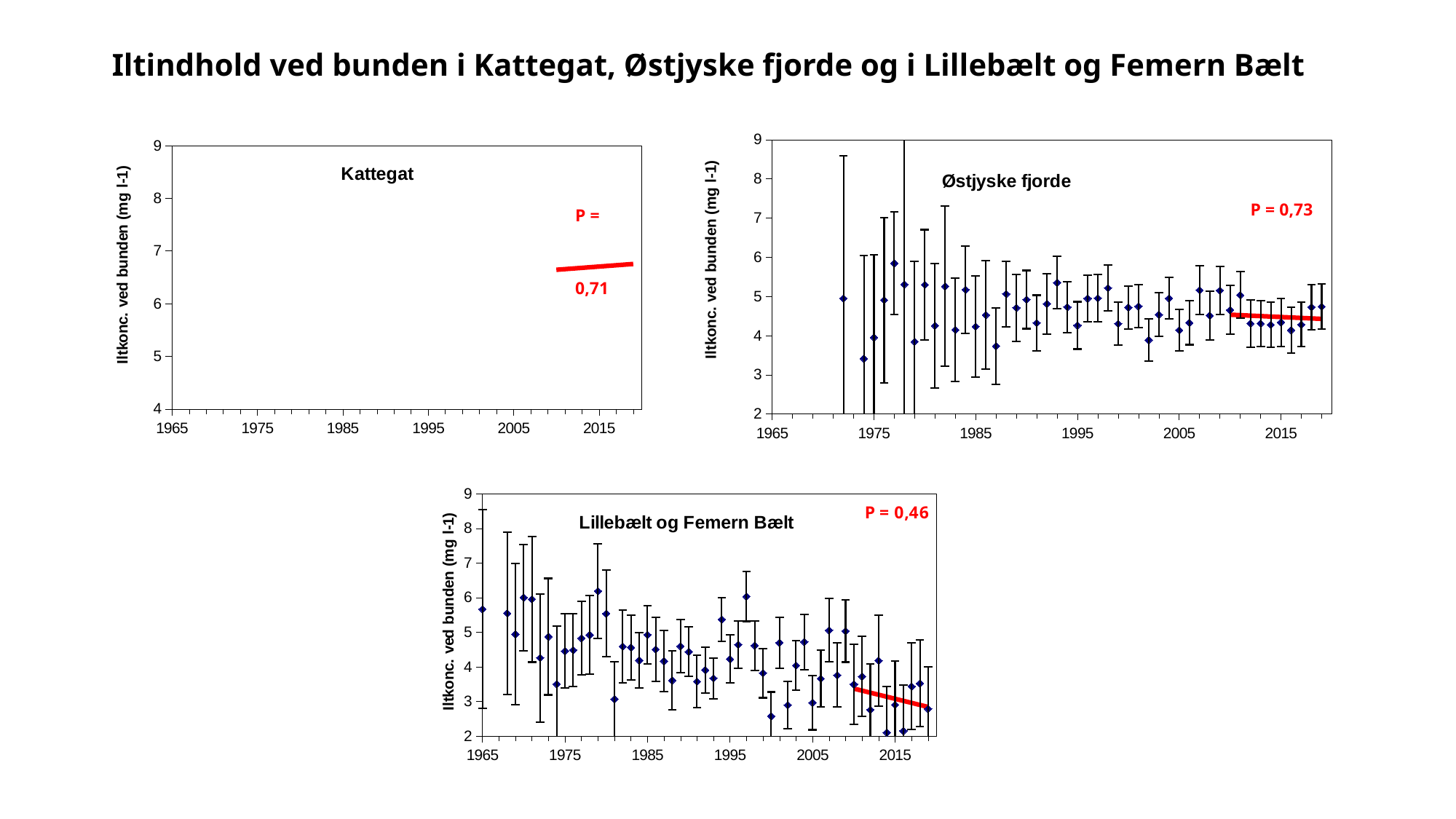
What is the y-axis label on the Lillebælt og Femern Bælt chart? Iltkonc. ved bunden (mg l-1) On the Kattegat chart, does the red trend line rise or fall along the x axis? rise How many charts are shown on the slide? 3 On the Østjyske fjorde chart, what P value is printed? 0,73 On the Kattegat chart, what P value is printed? 0,71 On the Lillebælt og Femern Bælt chart, is the value for 1965 greater or less than 5? greater On the Lillebælt og Femern Bælt chart, does the red trend line rise or fall from 2010 to 2019? fall On the Østjyske fjorde chart, is the value for 1977 greater or less than 5? greater On the Lillebælt og Femern Bælt chart, what P value is printed? 0,46 On the Østjyske fjorde chart, is the value for 1974 greater or less than 4? less What kind of chart is the Østjyske fjorde chart? scatter chart